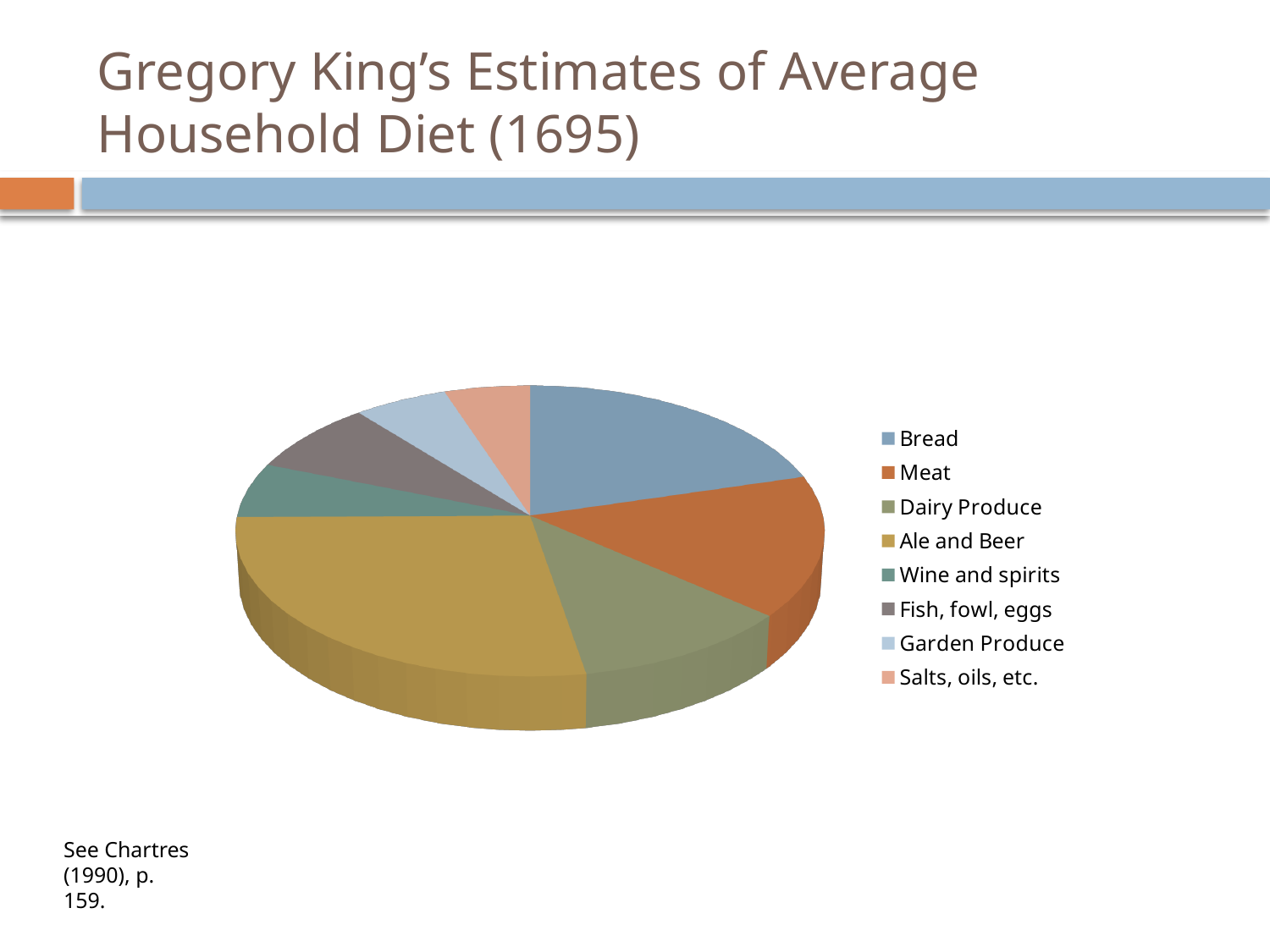
How many categories does the pie chart show? 8 Which category has the largest slice of the pie? Ale and Beer Which is larger, the slice for Ale and Beer or the slice for Garden Produce? Ale and Beer Which is larger, the slice for Bread or the slice for Wine and spirits? Bread Which category is listed first in the pie chart's legend? Bread Which is larger, the slice for Ale and Beer or the slice for Bread? Ale and Beer What kind of chart is shown on the slide? Pie chart What is the title of the slide containing the pie chart? Gregory King's Estimates of Average Household Diet (1695)